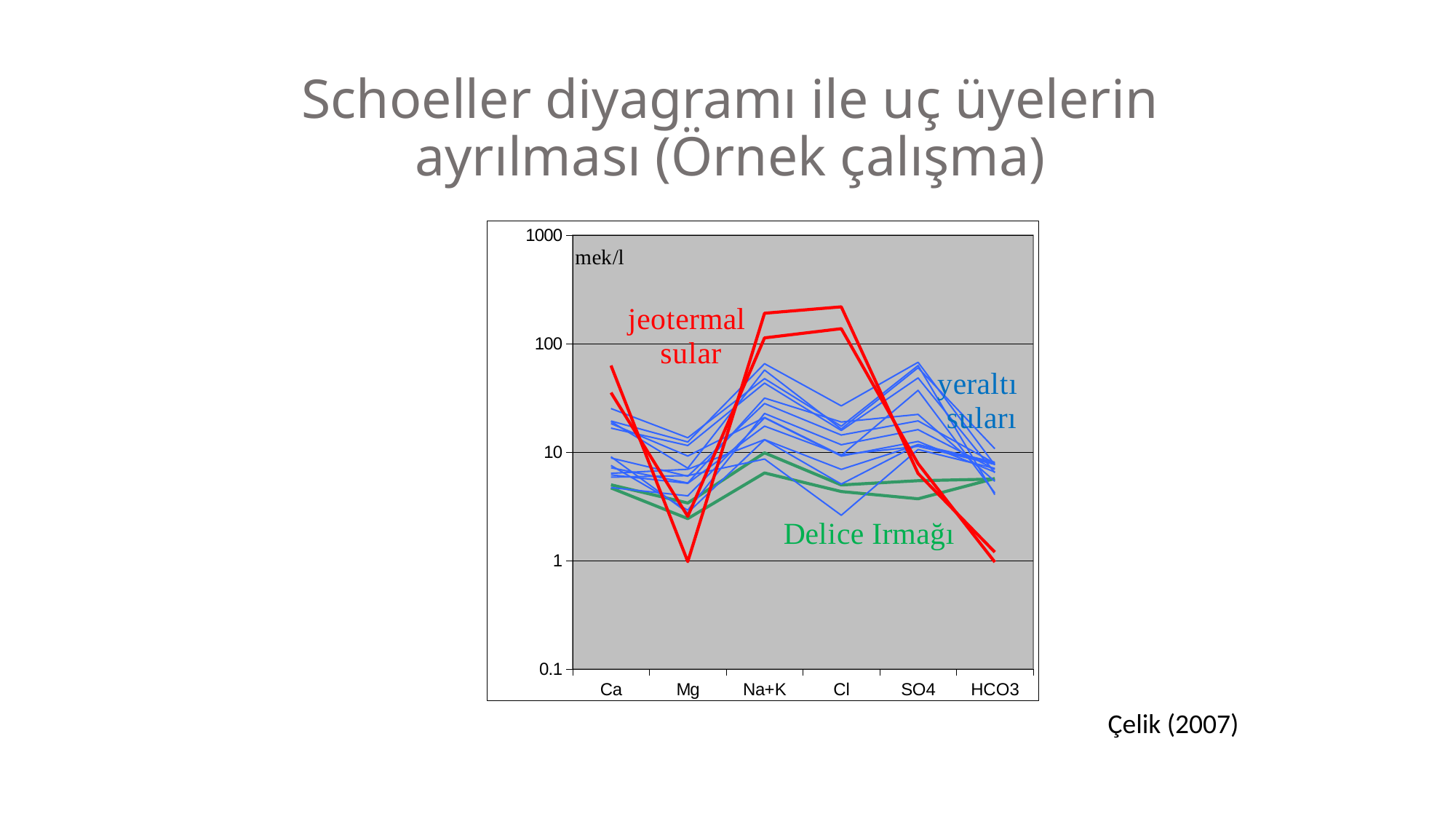
What unit is written inside the plot area of the chart? mek/l Is the value of the green (Delice Irmağı) line at Cl greater or less than 10? less Is the value of the green (Delice Irmağı) line at Mg greater or less than 10? less How many categories are shown on the x axis of the chart? 6 What is the highest value labelled on the y axis of the chart? 1000 Which group of waters is drawn in red on the chart? jeotermal sular Is the value of the red (jeotermal sular) lines at Cl greater or less than 100? greater Do the red (jeotermal sular) lines rise or fall from Na+K to HCO3? fall What kind of chart is shown on the slide? line chart